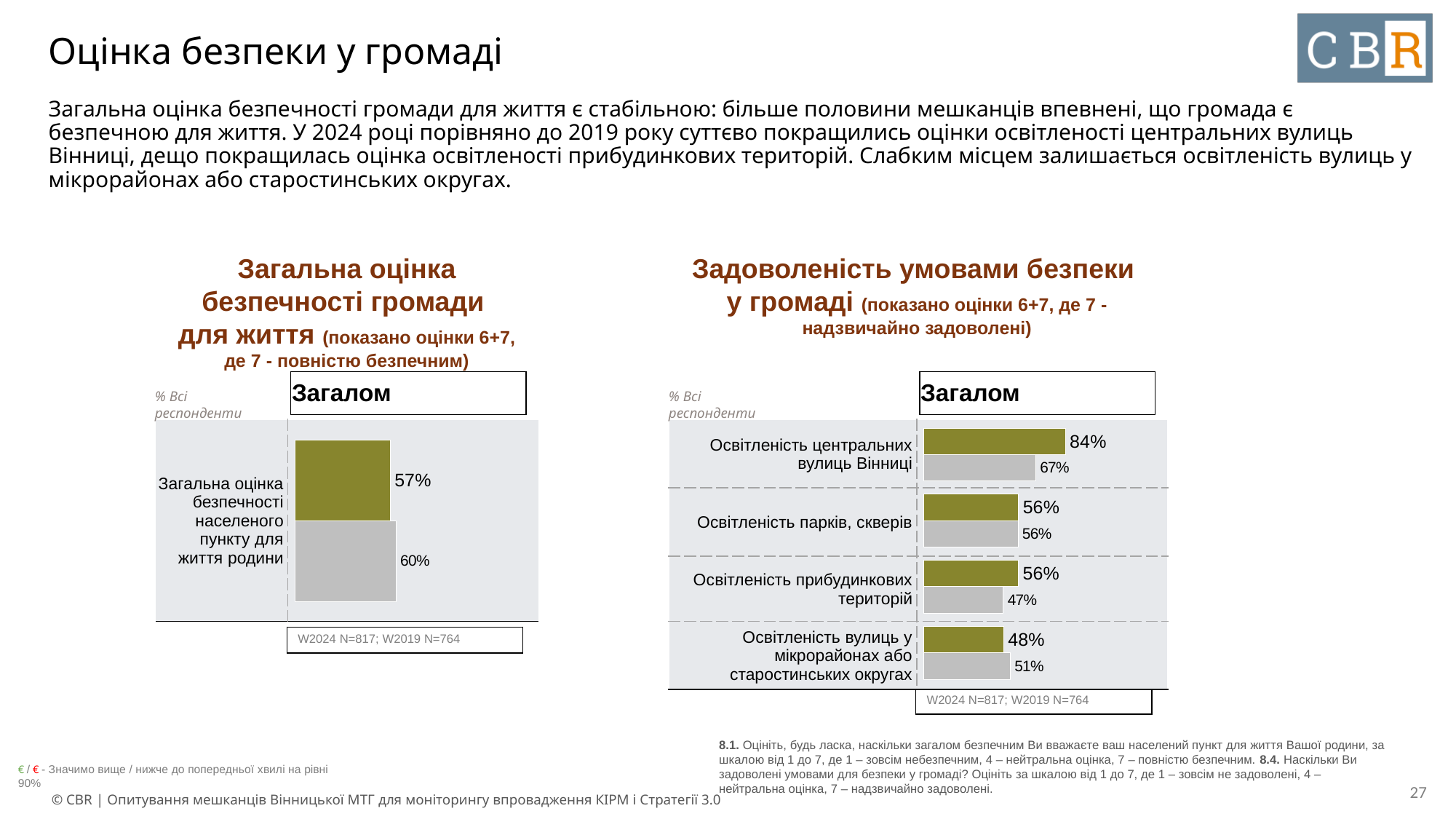
On the left chart 'Загальна оцінка безпечності громади для життя', what is the difference between the grey bar and the olive bar? 3 percentage points On the right chart 'Задоволеність умовами безпеки у громаді', what is the difference between the olive and grey values for 'Освітленість центральних вулиць Вінниці'? 17 percentage points According to the note under the right chart, what is the sample size N for W2024? 817 On the right chart 'Задоволеність умовами безпеки у громаді', for 'Освітленість вулиць у мікрорайонах або старостинських округах', which is larger: the olive (W2024) value or the grey (W2019) value? The grey (W2019) value, 51% On the right chart 'Задоволеність умовами безпеки у громаді', what is the grey (W2019) value for 'Освітленість прибудинкових територій'? 47% On the left chart 'Загальна оцінка безпечності громади для життя', what is the value of the olive (W2024) bar? 57% On the right chart 'Задоволеність умовами безпеки у громаді', what is the olive (W2024) value for 'Освітленість центральних вулиць Вінниці'? 84% What type of chart is the right chart 'Задоволеність умовами безпеки у громаді'? Bar chart On the right chart 'Задоволеність умовами безпеки у громаді', which category has the lowest olive (W2024) value? Освітленість вулиць у мікрорайонах або старостинських округах How many categories are shown on the right chart 'Задоволеність умовами безпеки у громаді'? 4 On the left chart 'Загальна оцінка безпечності громади для життя', what is the value of the grey (W2019) bar? 60% On the right chart 'Задоволеність умовами безпеки у громаді', which category has the highest olive (W2024) value? Освітленість центральних вулиць Вінниці